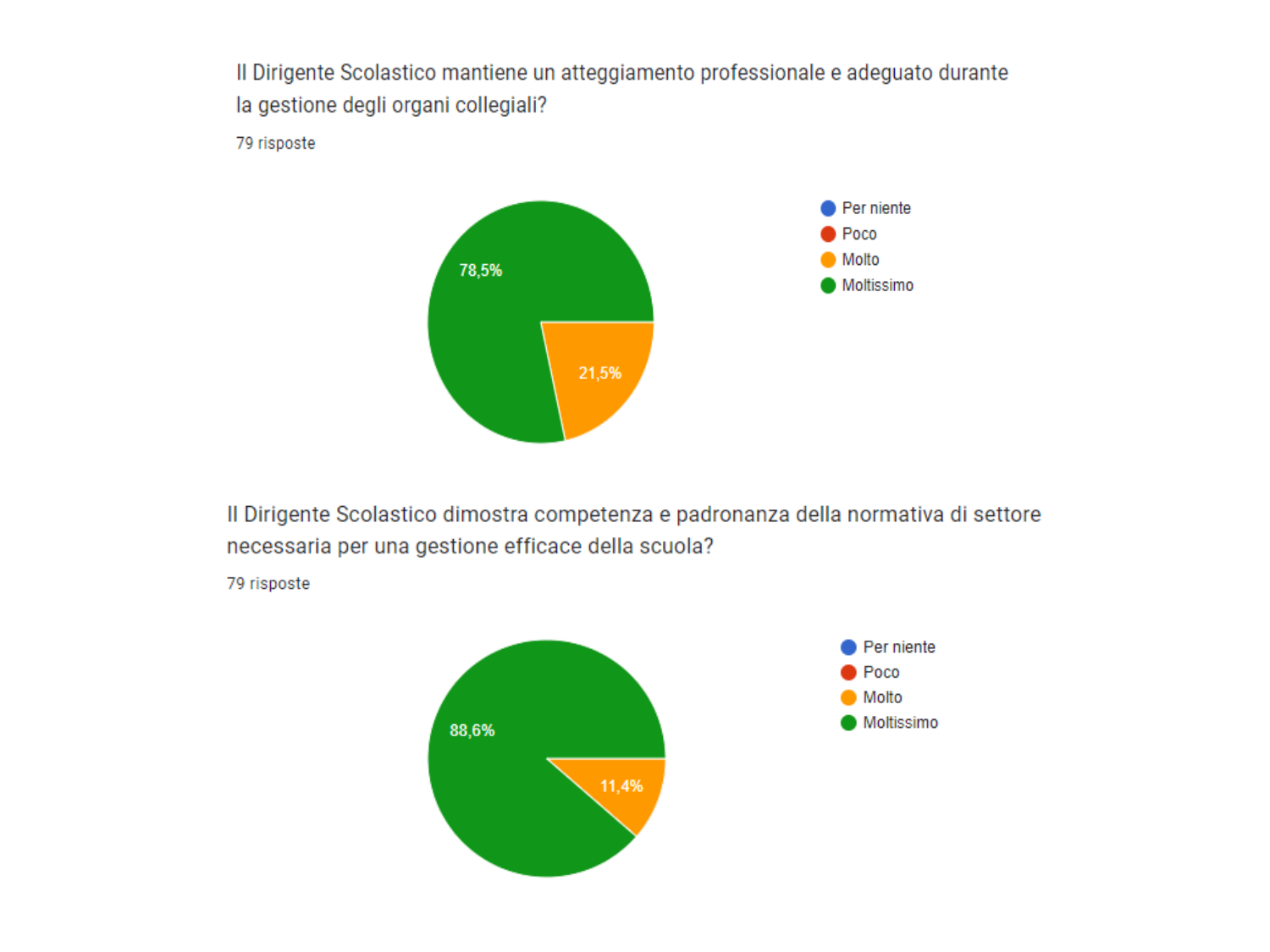
In the bottom pie chart, what is the difference between the 'Moltissimo' and 'Molto' shares? 77,2 percentage points What kind of chart is used on this slide? Pie chart In the top pie chart, which category has the largest slice? Moltissimo How many responses does the bottom chart report? 79 risposte In the top pie chart, what share of responses is 'Moltissimo'? 78,5% Is the 'Molto' share larger in the top pie chart or the bottom pie chart? Top pie chart In the top pie chart, what is the difference between the 'Moltissimo' and 'Molto' shares? 57 percentage points In the bottom pie chart, what share of responses is 'Moltissimo'? 88,6% In the top pie chart, what share of responses is 'Molto'? 21,5% In the bottom pie chart, which category has the largest slice? Moltissimo In the bottom pie chart, what share of responses is 'Molto'? 11,4% How many entries does the legend of the top chart list? 4